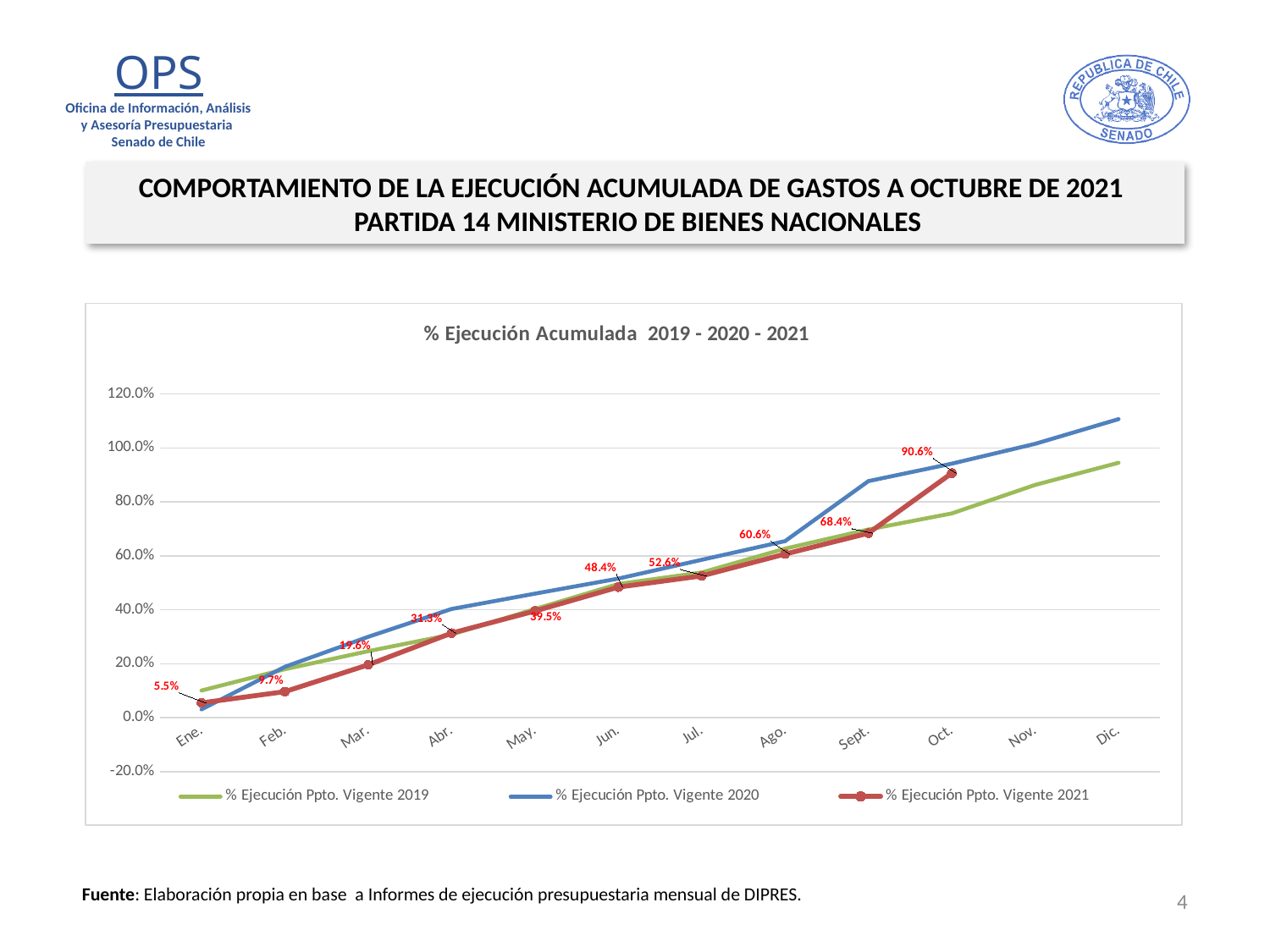
How many months are shown along the x axis? 12 What is the difference between the Oct. and Sept. values for % Ejecución Ppto. Vigente 2021? 22.2 percentage points What is the value for % Ejecución Ppto. Vigente 2021 in Ago.? 60.6% How many series does the legend list? 3 Does the % Ejecución Ppto. Vigente 2021 series rise or fall from Ene. to Oct.? Rise What is the value for % Ejecución Ppto. Vigente 2021 in Sept.? 68.4% In which month does the % Ejecución Ppto. Vigente 2021 series reach its highest value? Oct. Is the value for % Ejecución Ppto. Vigente 2020 in Dic. greater or less than 100.0%? greater What kind of chart is shown on the slide? Line chart What is the value for % Ejecución Ppto. Vigente 2021 in Oct.? 90.6% What is the title of the chart? % Ejecución Acumulada 2019 - 2020 - 2021 What is the value for % Ejecución Ppto. Vigente 2021 in Ene.? 5.5%